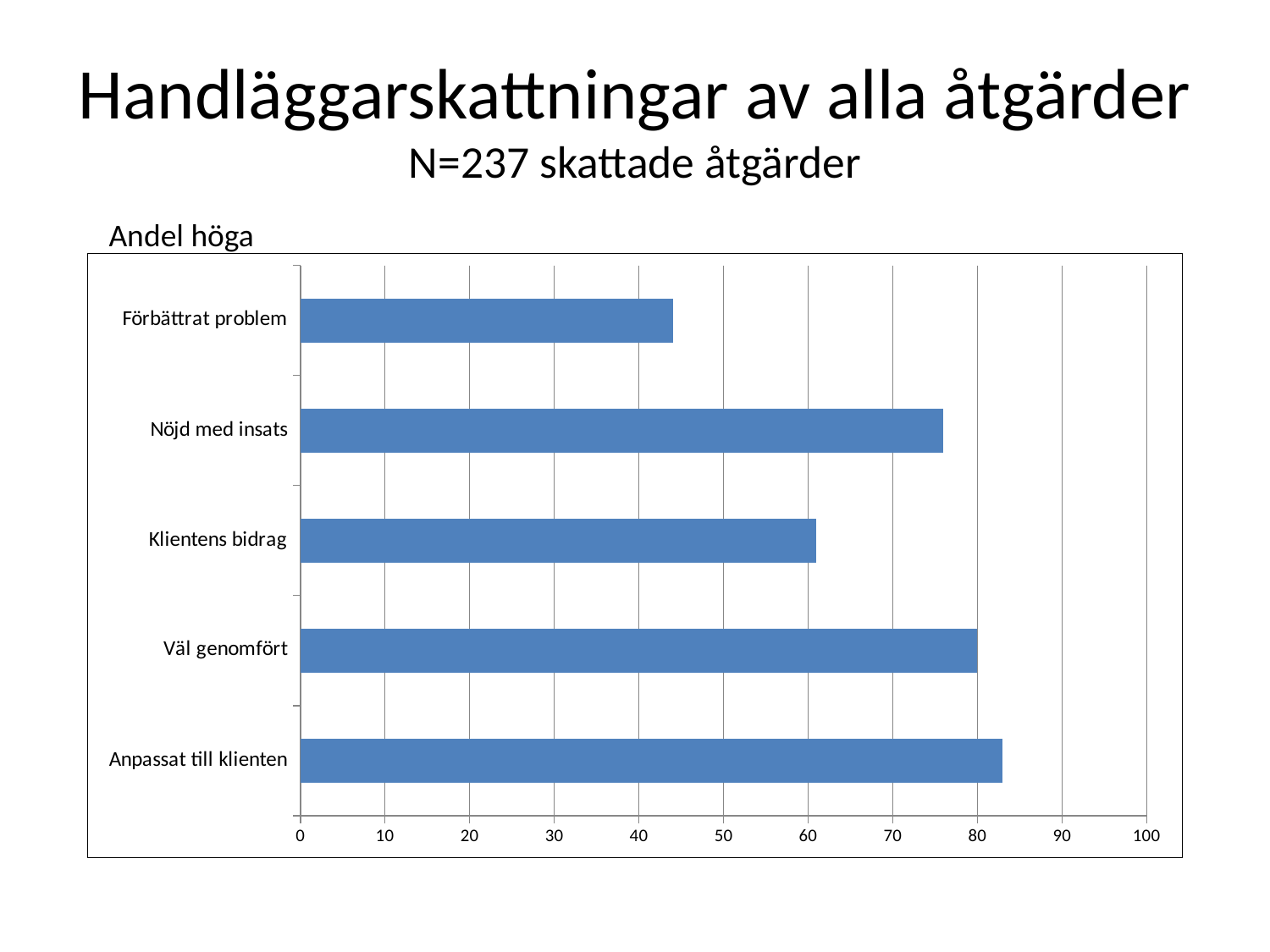
What kind of chart is shown on the slide? bar chart Which is larger, the value for Nöjd med insats or the value for Klientens bidrag? Nöjd med insats Is the value for Väl genomfört greater or less than 70? greater Which category has the highest value? Anpassat till klienten Which is larger, the value for Förbättrat problem or the value for Väl genomfört? Väl genomfört Which category has the lowest value? Förbättrat problem How many categories are plotted in the chart? 5 Is the value for Klientens bidrag greater or less than 50? greater Is the value for Anpassat till klienten greater or less than 80? greater What is the label shown above the chart? Andel höga